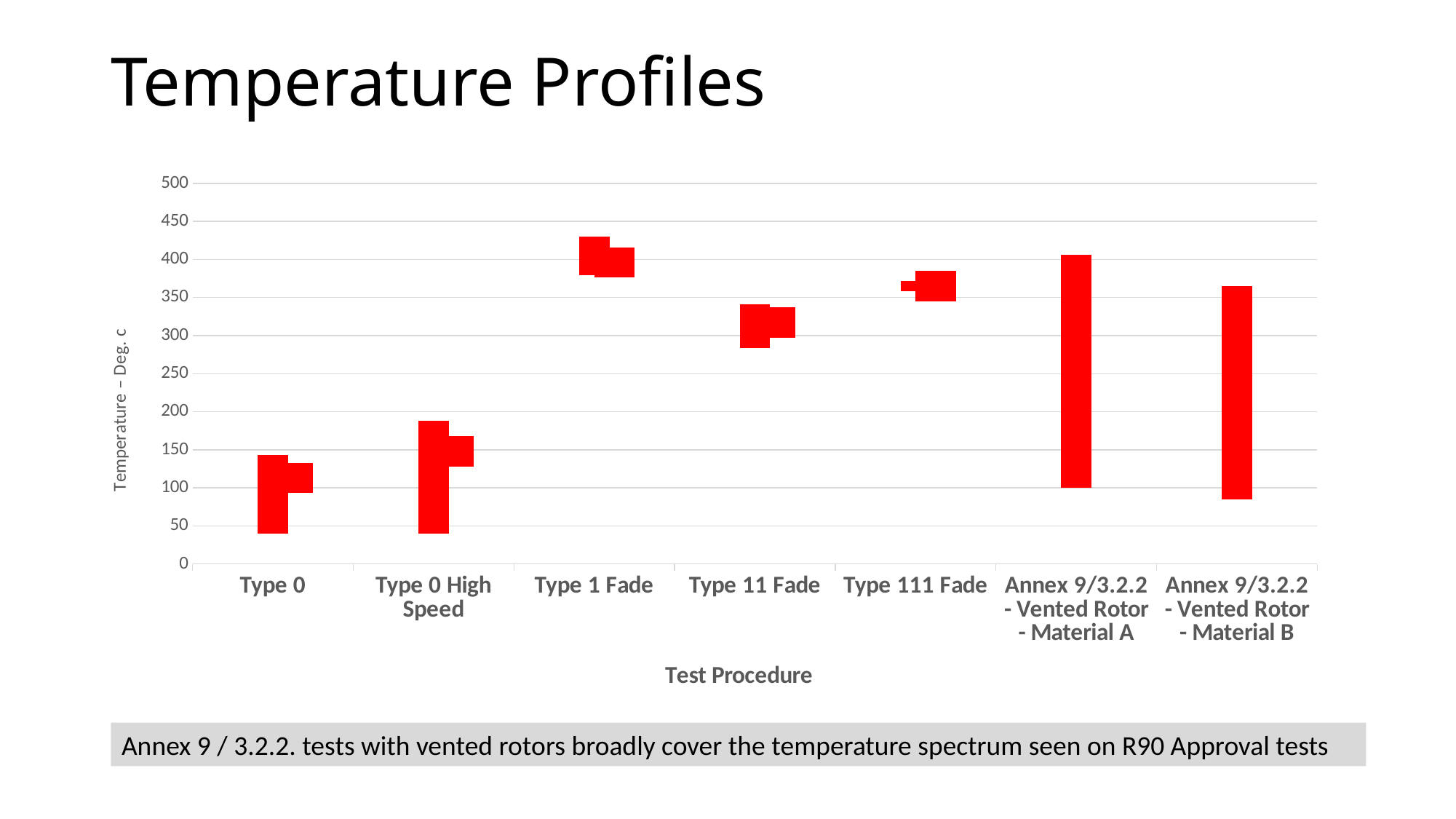
Is the top of the bar for Type 1 Fade greater or less than 400? greater Which reaches a higher temperature, Type 0 or Type 0 High Speed? Type 0 High Speed Which test procedure reaches the highest temperature on the chart? Type 1 Fade Is the top of the bar for Type 111 Fade greater or less than 400? less How many test procedures are shown on the x axis of the chart? 7 Is the bottom of the bar for Type 11 Fade greater or less than 300? less Which reaches a higher temperature, Type 1 Fade or Type 11 Fade? Type 1 Fade What is the title of the chart's horizontal axis? Test Procedure What kind of chart is shown on the slide? bar chart What is the title of the chart's vertical axis? Temperature – Deg. c